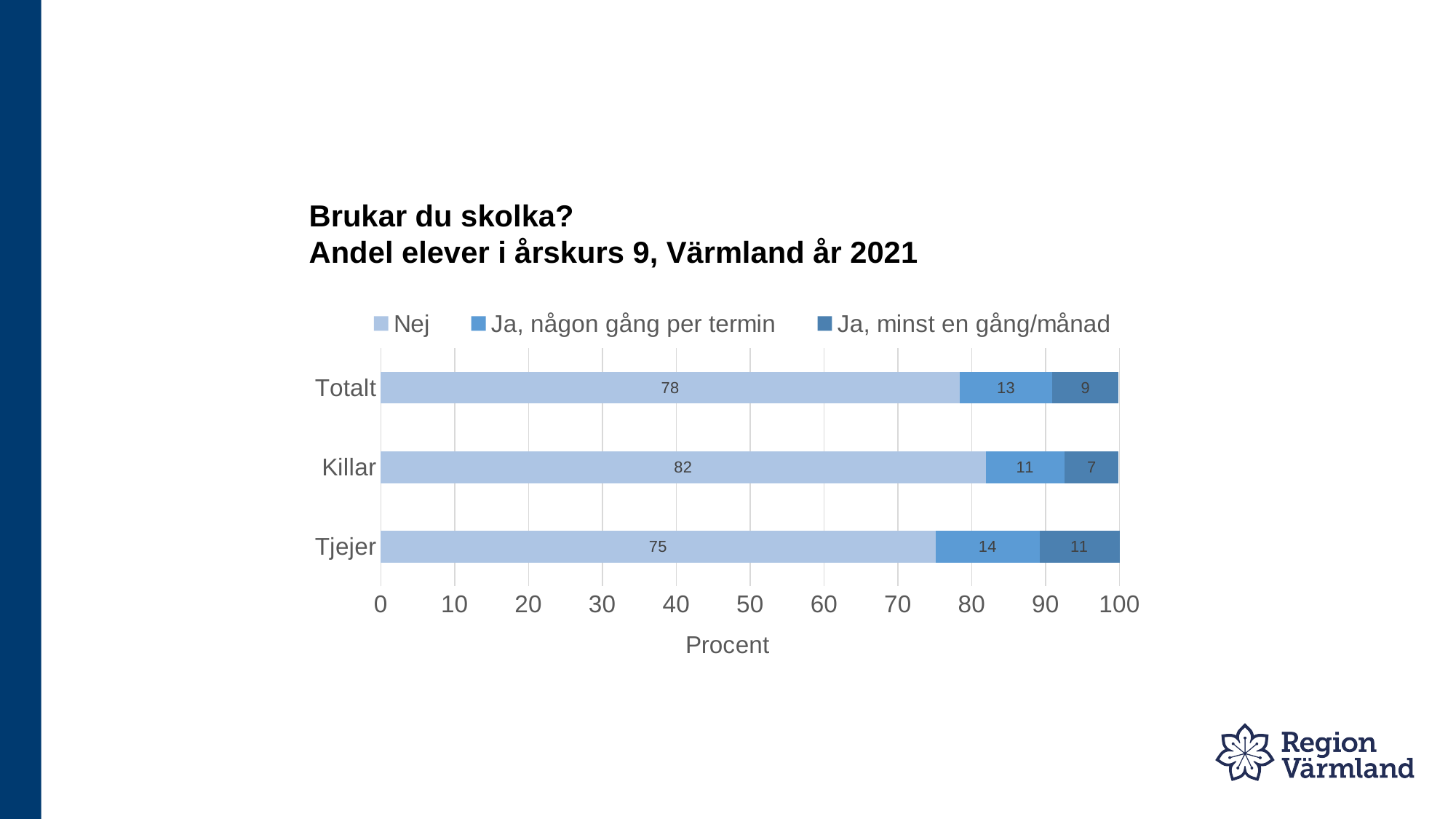
Which is larger: the "Ja, någon gång per termin" value for Tjejer or for Killar? Tjejer What is the value for "Ja, någon gång per termin" for Totalt? 13 What is the difference between the "Nej" values for Killar and Tjejer? 7 What is the value for "Nej" for Killar? 82 How many categories are shown on the y axis? 3 How many series does the legend list? 3 Which category has the lowest value for "Ja, minst en gång/månad"? Killar What kind of chart is shown? Stacked bar chart What is the total of the stacked bar for Tjejer? 100 Is the "Nej" value for Totalt greater or less than 70? greater Which category has the highest value for "Nej"? Killar What is the value for "Ja, minst en gång/månad" for Tjejer? 11